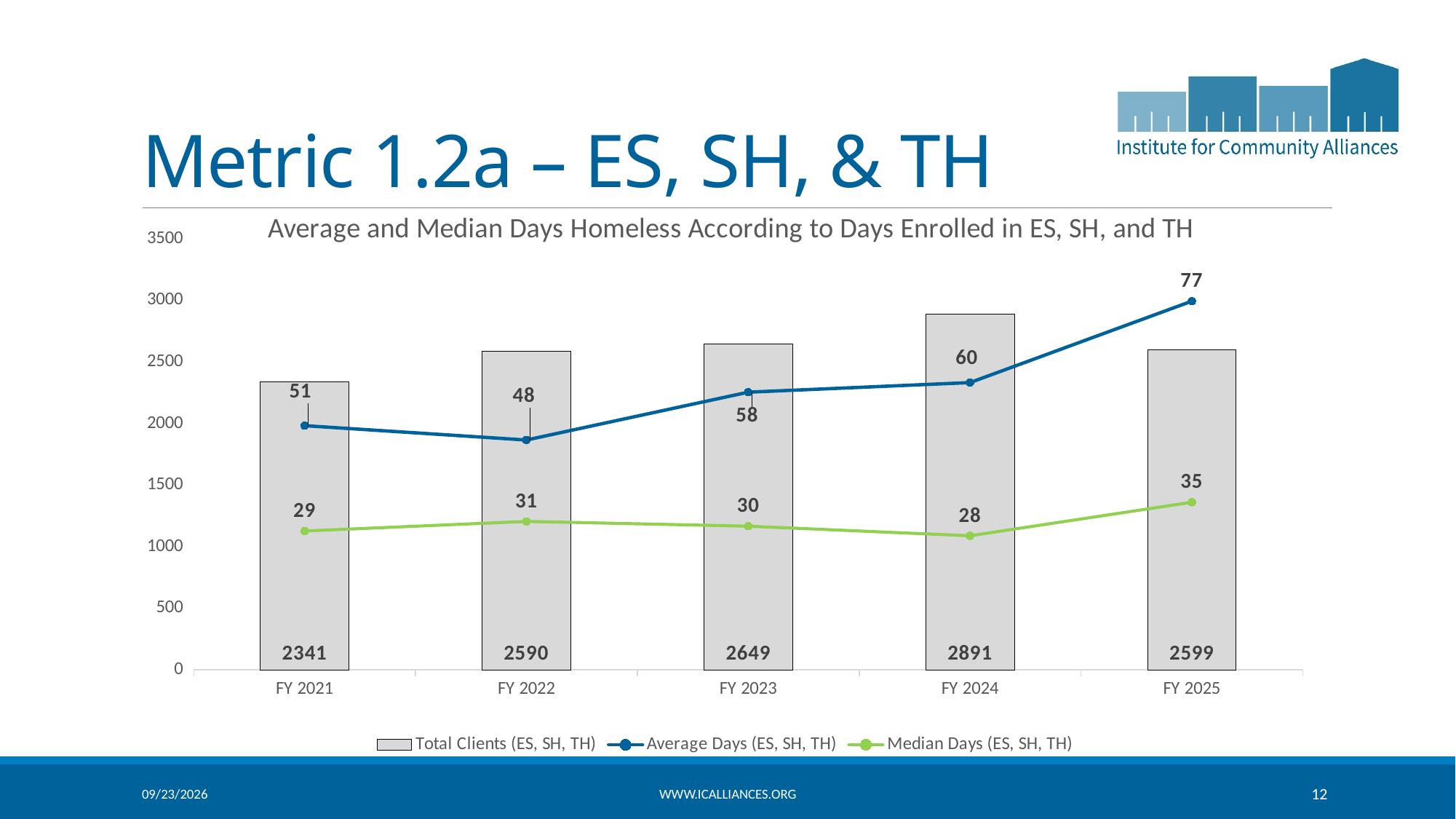
Is the Total Clients (ES, SH, TH) bar for FY 2021 greater or less than 2500? less What kind of chart is shown on the slide? Combined bar and line chart How many fiscal years are shown on the x axis? 5 Which is larger, the Median Days (ES, SH, TH) for FY 2021 or for FY 2025? FY 2025 What is the Median Days (ES, SH, TH) value for FY 2022? 31 Does the Average Days (ES, SH, TH) line rise or fall from FY 2022 to FY 2025? rise What is the difference in Total Clients (ES, SH, TH) between FY 2024 and FY 2025? 292 What is the Average Days (ES, SH, TH) value for FY 2025? 77 How many series does the legend list? 3 Which fiscal year has the lowest Average Days (ES, SH, TH)? FY 2022 Which fiscal year has the highest Total Clients (ES, SH, TH)? FY 2024 What is the value of Total Clients (ES, SH, TH) for FY 2024? 2891